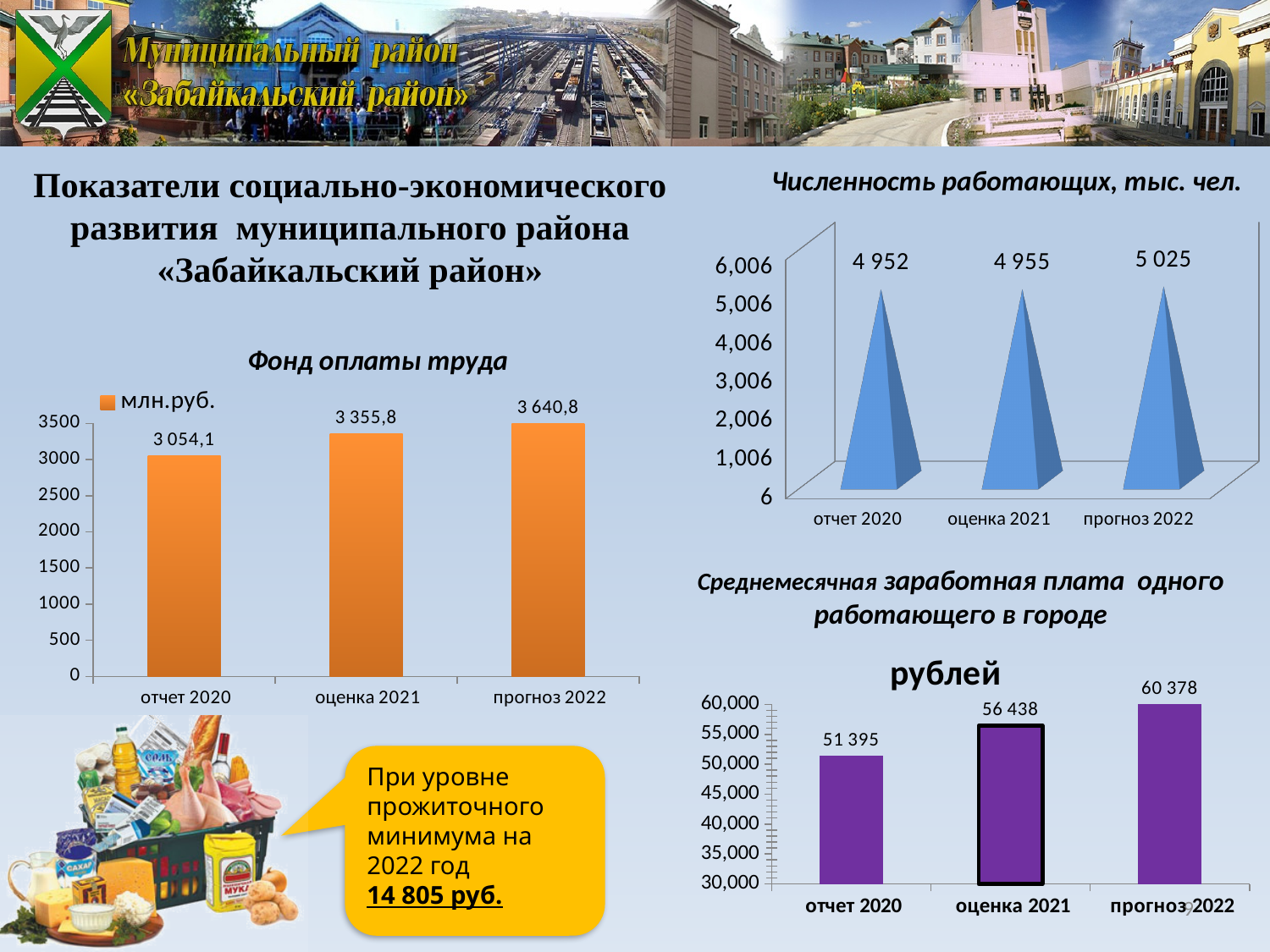
In the 'Численность работающих, тыс. чел.' chart, which category has the highest value? прогноз 2022 In the 'Фонд оплаты труда' chart, what series name does the legend show? млн.руб. In the 'Среднемесячная заработная плата одного работающего в городе' chart, what is the difference between 'прогноз 2022' and 'отчет 2020'? 8 983 In the 'Численность работающих, тыс. чел.' chart, how many categories are shown on the x axis? 3 In the 'Фонд оплаты труда' chart, what is the value for 'оценка 2021'? 3 355,8 What kind of chart is the 'Фонд оплаты труда' chart? bar chart In the 'Численность работающих, тыс. чел.' chart, what is the difference between 'прогноз 2022' and 'отчет 2020'? 73 In the 'Среднемесячная заработная плата одного работающего в городе' chart, do the values rise or fall from 'отчет 2020' to 'прогноз 2022'? rise In the 'Среднемесячная заработная плата одного работающего в городе' chart, what is the value for 'оценка 2021'? 56 438 In the 'Численность работающих, тыс. чел.' chart, what is the value for 'отчет 2020'? 4 952 In the 'Фонд оплаты труда' chart, what is the value for 'прогноз 2022'? 3 640,8 In the 'Фонд оплаты труда' chart, what is the difference between 'прогноз 2022' and 'отчет 2020'? 586,7